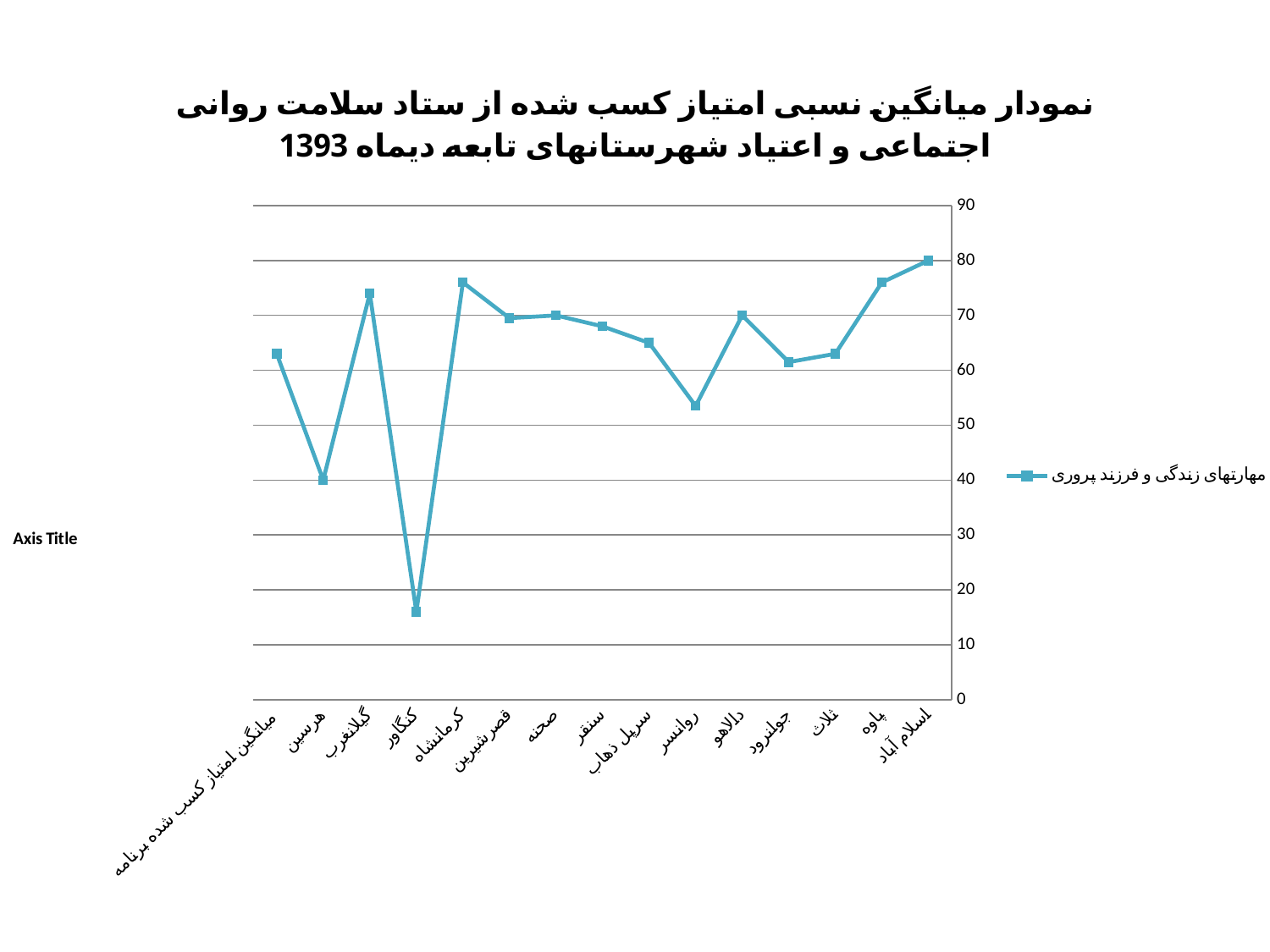
What is the value for هرسین? 40 Which category has the lowest value? کنگاور What kind of chart is shown on the slide? line chart Which category has the highest value? اسلام آباد Is the value for روانسر greater or less than 50? greater What is the value for اسلام آباد? 80 Which is larger, the value for هرسین or the value for کنگاور? هرسین How many series does the legend list? 1 Is the value for کنگاور greater or less than 20? less Is the value for گیلانغرب greater or less than 70? greater How many categories are plotted along the x axis? 15 What is the name of the series shown in the legend? مهارتهای زندگی و فرزند پروری